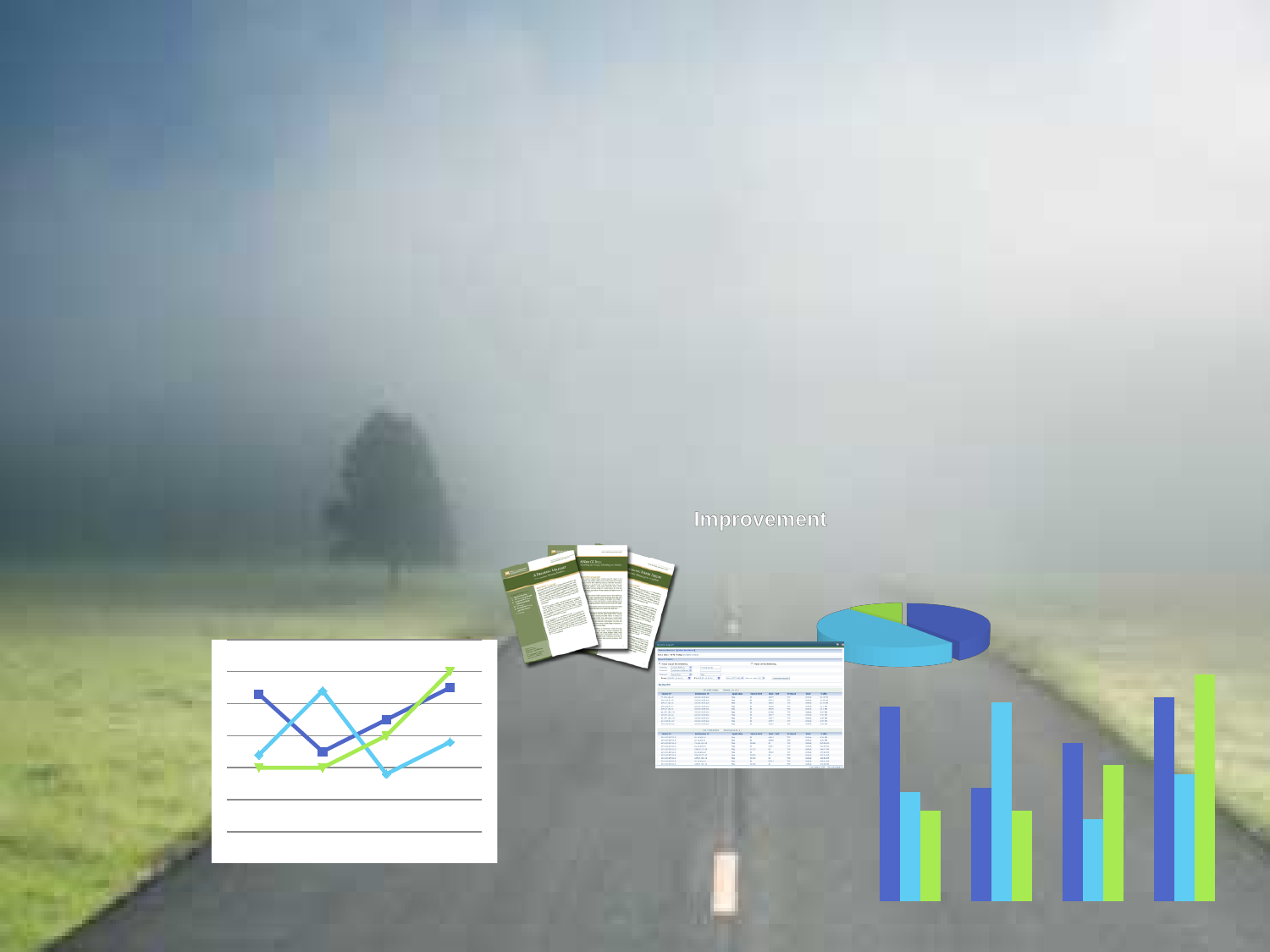
In the line chart at the bottom left, how many points does each line have? 4 In the pie chart, how many slices are there? 3 In the line chart at the bottom left, how many lines are plotted? 3 What kind of chart is shown at the bottom left of the slide? line chart In the pie chart, which colour is the smallest slice? green What kind of chart is shown at the right of the slide, above the bar chart? pie chart In the bar chart at the bottom right, which colour is the tallest bar overall? green In the line chart at the bottom left, does the green line rise or fall from left to right overall? rise In the bar chart at the bottom right, which colour bar is tallest in the leftmost group? dark blue What kind of chart is shown at the bottom right of the slide? bar chart